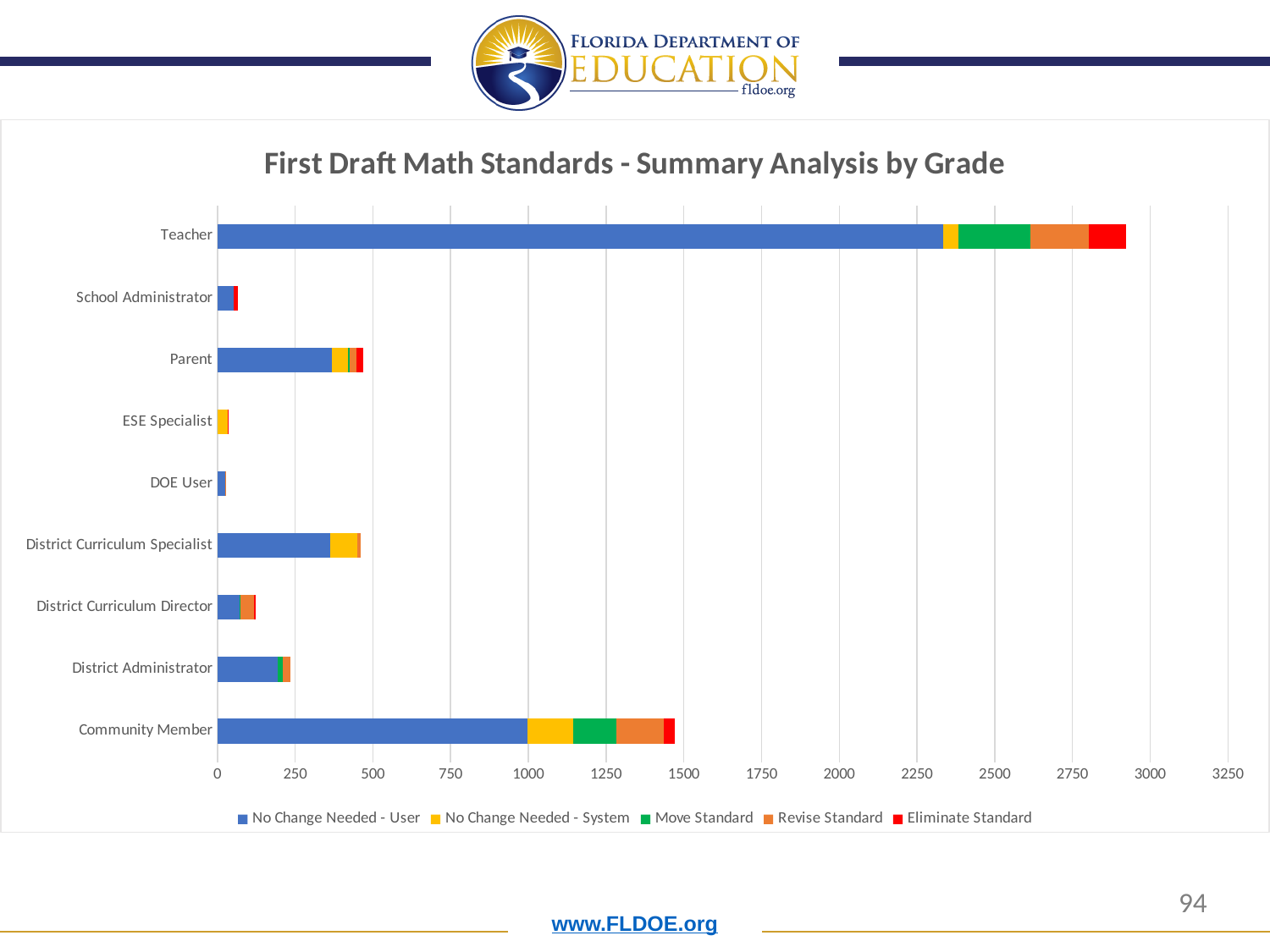
What colour represents the Eliminate Standard series in the legend? Red Which category has the longest total bar? Teacher How many series does the legend list? 5 Is the total bar for Parent greater or less than 500? less What is the title of the chart? First Draft Math Standards - Summary Analysis by Grade Is the total bar for Community Member greater or less than 1500? less Which has a longer total bar, District Curriculum Specialist or District Curriculum Director? District Curriculum Specialist How many categories (respondent types) are shown on the chart? 9 What kind of chart is shown on the slide? Stacked bar chart Which has a longer total bar, Parent or School Administrator? Parent Is the total bar for Teacher greater or less than 2750? greater